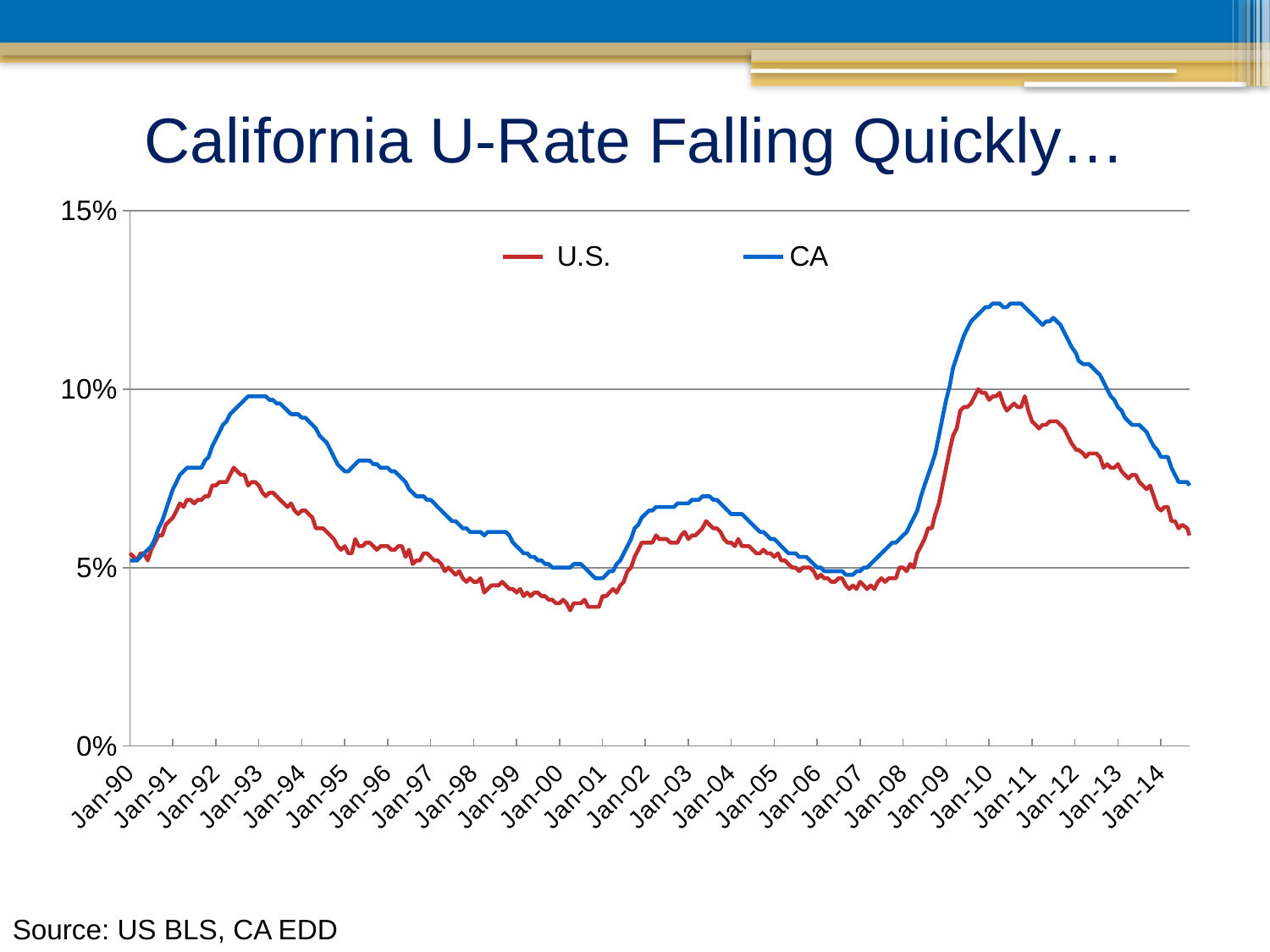
Is the value for CA at Jan-10 greater or less than 10%? greater What kind of chart is shown on the slide? line chart How many year labels are shown on the x axis? 25 What is the title of the chart on the slide? California U-Rate Falling Quickly… Which series reaches the highest peak on the chart? CA Is the value for U.S. at Jan-00 greater or less than 5%? less How many series does the legend list? 2 Does the CA line rise or fall between Jan-10 and Jan-14? fall Which colour is used for the CA line? blue Is the value for CA at Jan-14 greater or less than 5%? greater Which series has the higher value at Jan-10, U.S. or CA? CA